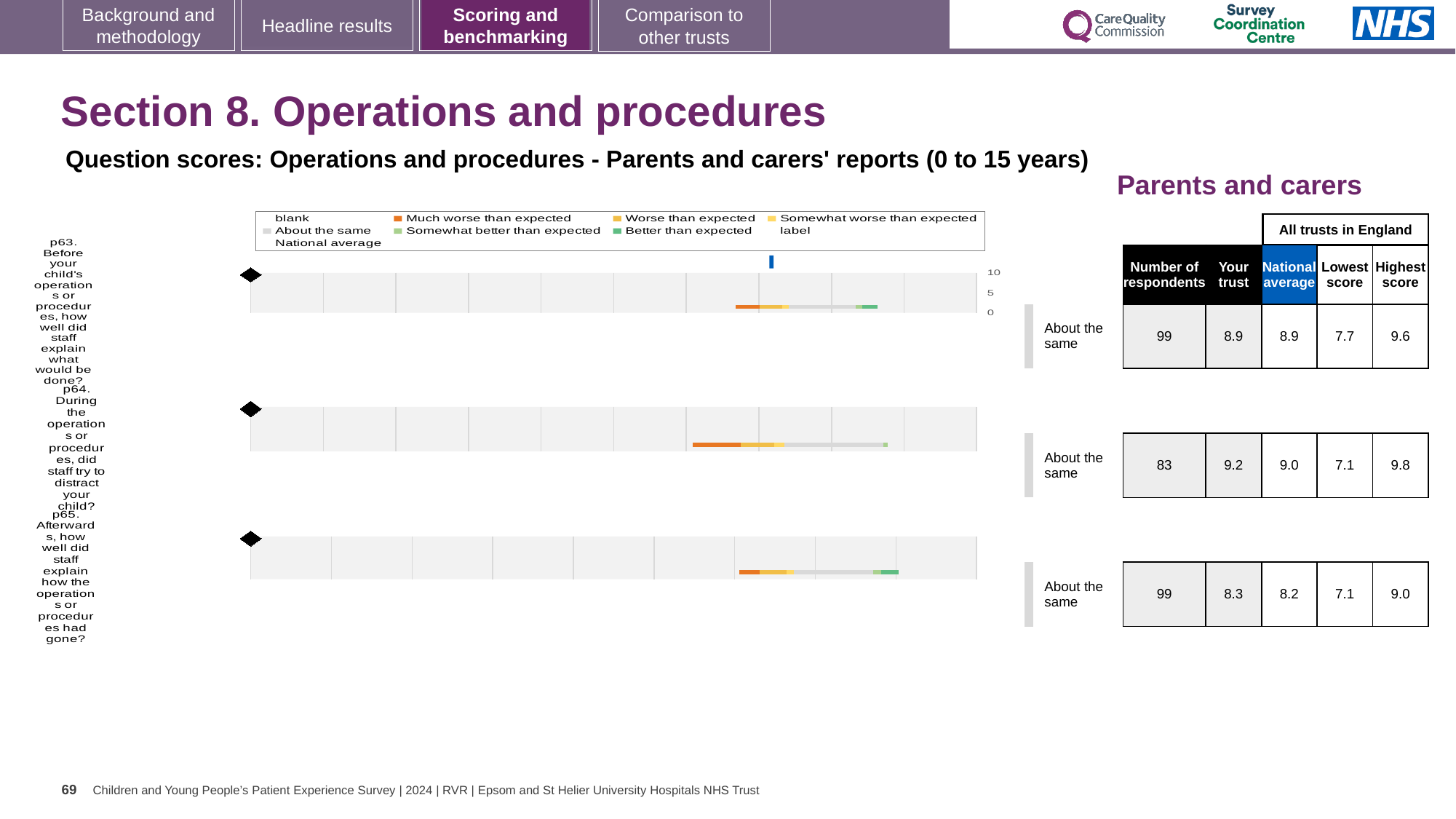
For p64, is the 'Your trust' score or the national average larger? Your trust What colour represents 'Much worse than expected' in the legend? Orange What is the national average score for p65 (Afterwards, how well did staff explain how the operations or procedures had gone?)? 8.2 What is the highest score among all trusts in England for p63? 9.6 What type of chart is used to show the question scores on this slide? bar chart What benchmark category is shown for p63? About the same Which question has the highest 'Your trust' score? p64 How many questions (p63, p64, p65) are plotted on this slide? 3 What is the difference between the highest score and the lowest score for p64? 2.7 What is the 'Your trust' score for p64 (During the operations or procedures, did staff try to distract your child?)? 9.2 Which question has the lowest 'Your trust' score? p65 How many respondents answered p64? 83